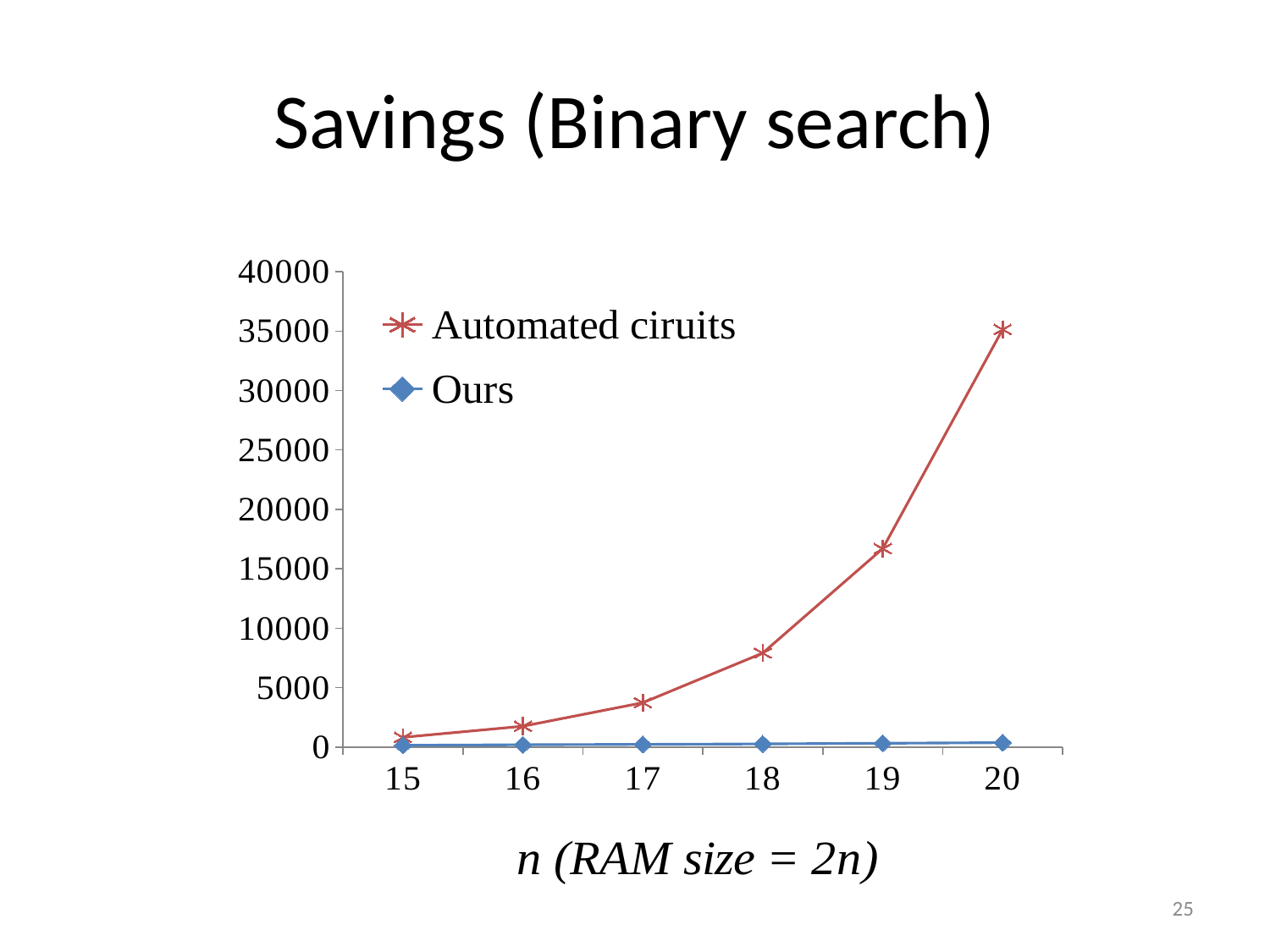
What kind of chart is shown on the slide? line chart At which value of n is the Automated ciruits series lowest? 15 Is the value for Ours at n = 20 greater or less than 5000? less What is the label of the x axis? n (RAM size = 2n) Do the values of the Automated ciruits series rise or fall as n increases? rise Is the value for Automated ciruits at n = 18 greater or less than 10000? less How many series does the legend list? 2 What is the title of the chart? Savings (Binary search) At n = 20, which series has the larger value, Automated ciruits or Ours? Automated ciruits Is the value for Automated ciruits at n = 20 greater or less than 30000? greater How many values of n are plotted along the x axis? 6 At which value of n is the Automated ciruits series highest? 20